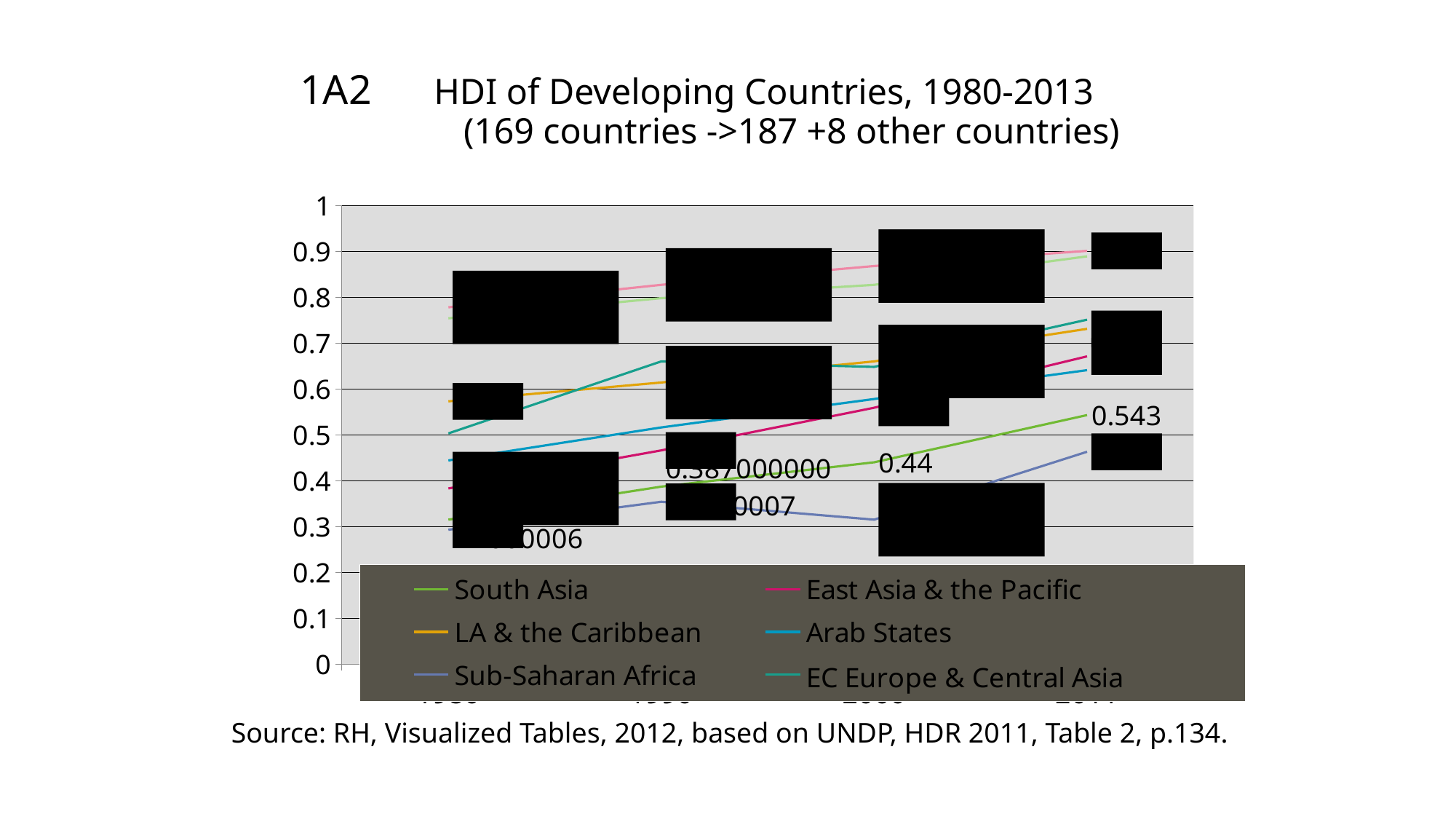
Is the value for Sub-Saharan Africa in 2000 greater or less than 0.4? less Which is higher in 1980, LA & the Caribbean or Arab States? LA & the Caribbean What kind of chart is shown on the slide? line chart Does the South Asia line rise or fall from 1980 to 2011? rise How many series does the legend list? 6 Is the value for Sub-Saharan Africa in 2011 greater or less than 0.5? less Is the value for Arab States in 1980 greater or less than 0.5? less What is the title of the chart? HDI of Developing Countries, 1980-2013 (169 countries ->187 +8 other countries) What is the HDI value for South Asia in 2000? 0.44 What is the HDI value for South Asia in 2011? 0.543 By how much did the South Asia HDI value increase from 2000 to 2011? 0.103 Which is higher in 2011, South Asia or Sub-Saharan Africa? South Asia